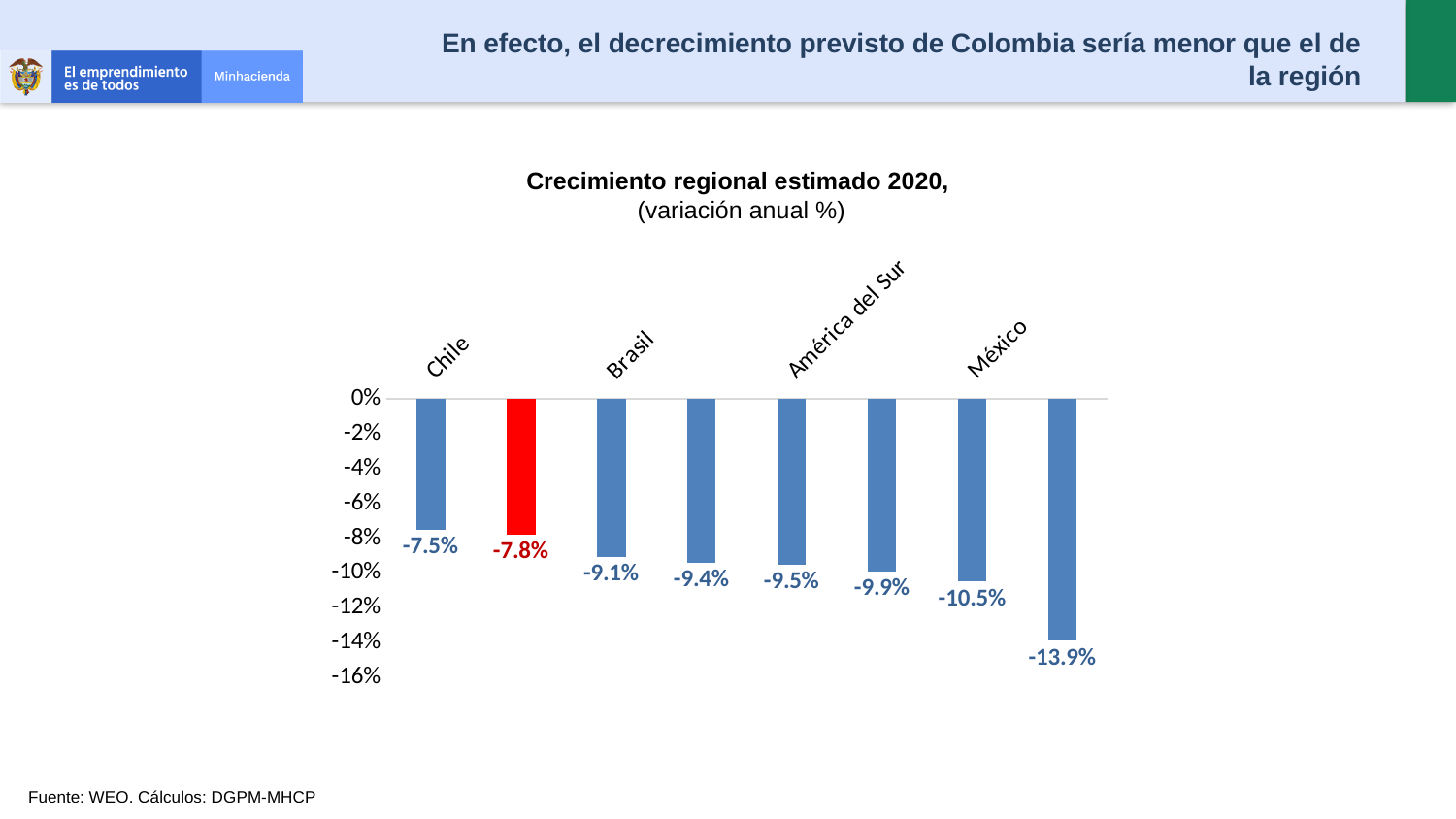
What is the value for Chile in the chart? -7.5% Do the values rise or fall moving from left to right across the chart? Fall What kind of chart is shown on the slide? Bar chart Which has the higher (less negative) value, Brasil or México? Brasil What is the lowest value shown in the chart? -13.9% Which category has the highest (least negative) value in the chart? Chile What value is shown on the red bar? -7.8% What is the value for México in the chart? -10.5% How many bars are plotted in the chart? 8 What is the value for América del Sur in the chart? -9.5% What is the difference in percentage points between the values for Chile and México? 3.0 percentage points What is the value for Brasil in the chart? -9.1%